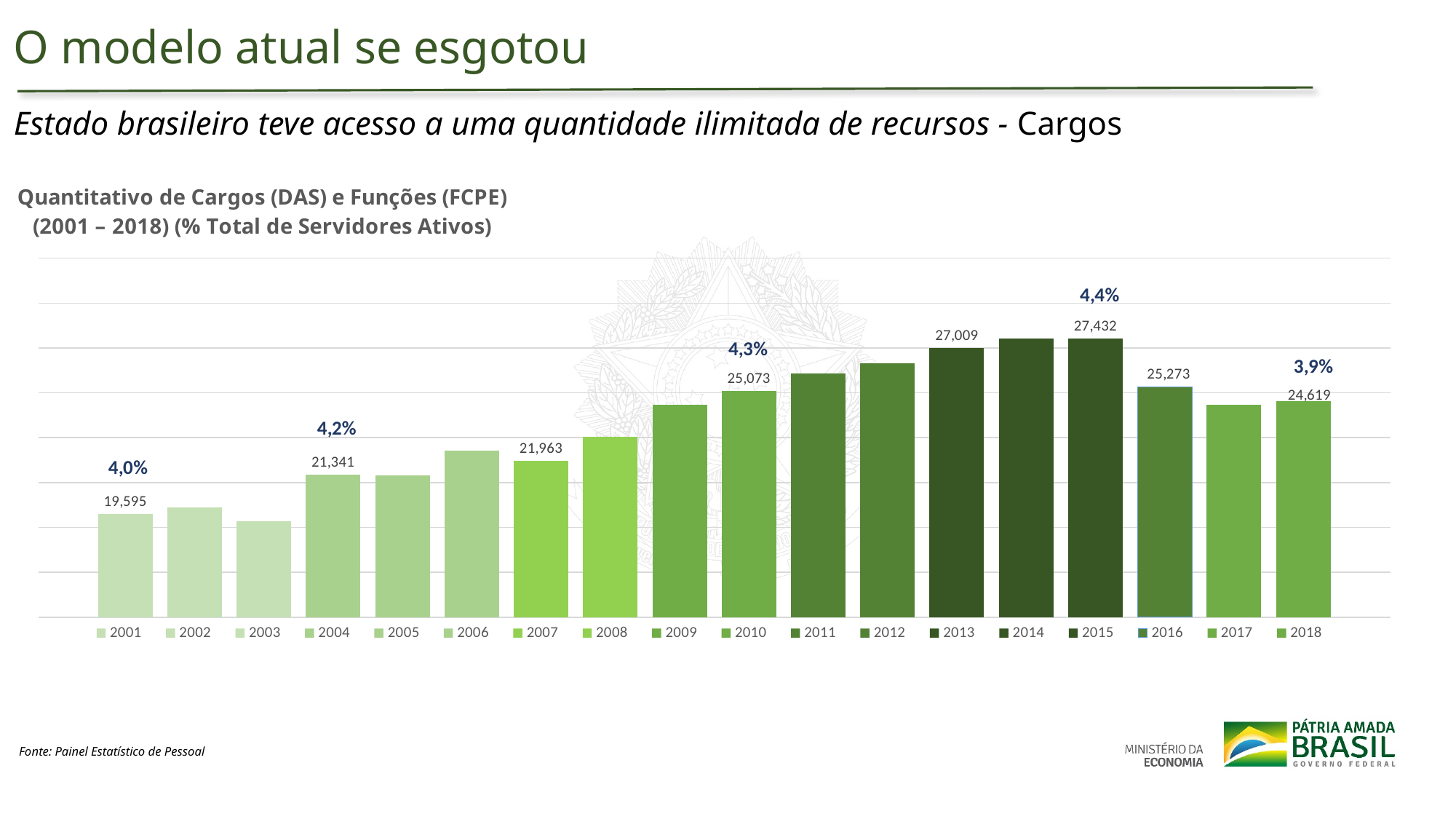
What kind of chart is shown on the slide? Bar chart Which is larger, the value for 2016 or the value for 2018? 2016 How many years are shown on the x axis? 18 What is the value shown for 2001? 19,595 What is the difference between the values for 2015 and 2001? 7,837 What is the difference between the values for 2013 and 2010? 1,936 What is the value shown for 2015? 27,432 What percentage of total active servants is shown above the 2010 bar? 4,3% Which year has the lowest bar? 2003 What is the value shown for 2018? 24,619 What percentage of total active servants is shown above the 2018 bar? 3,9% Do the values rise or fall from 2015 to 2018? Fall